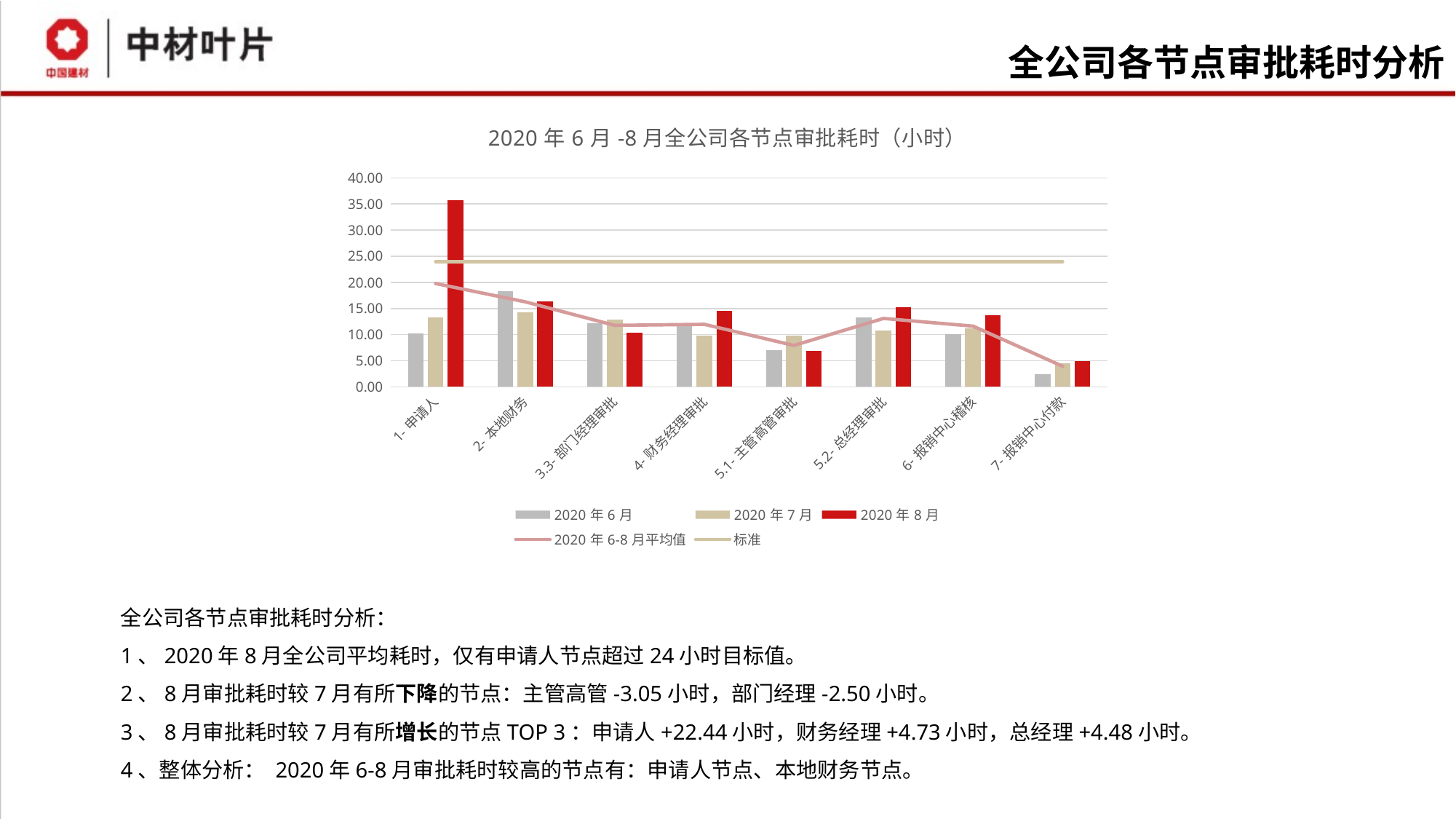
Which node has the lowest value for 2020 年 6 月? 7- 报销中心付款 For 2020 年 8 月, which node has the larger value: 1- 申请人 or 2- 本地财务? 1- 申请人 Is the 2020 年 6 月 value for 7- 报销中心付款 greater or less than 5.00? less How many categories (nodes) are shown on the x axis of the chart? 8 How many series does the chart legend list? 5 Does the 标准 line rise, fall, or stay flat across the nodes? stays flat Which node has the highest value for 2020 年 8 月? 1- 申请人 What is the title of the chart? 2020 年 6 月 -8 月全公司各节点审批耗时（小时） Is the 2020 年 8 月 value for 5.1- 主管高管审批 greater or less than 10.00? less What kind of chart is used to show the monthly values for each node? bar chart For 1- 申请人, which is larger: the 2020 年 6 月 value or the 2020 年 7 月 value? 2020 年 7 月 Is the 2020 年 8 月 value for 1- 申请人 greater or less than 30.00? greater